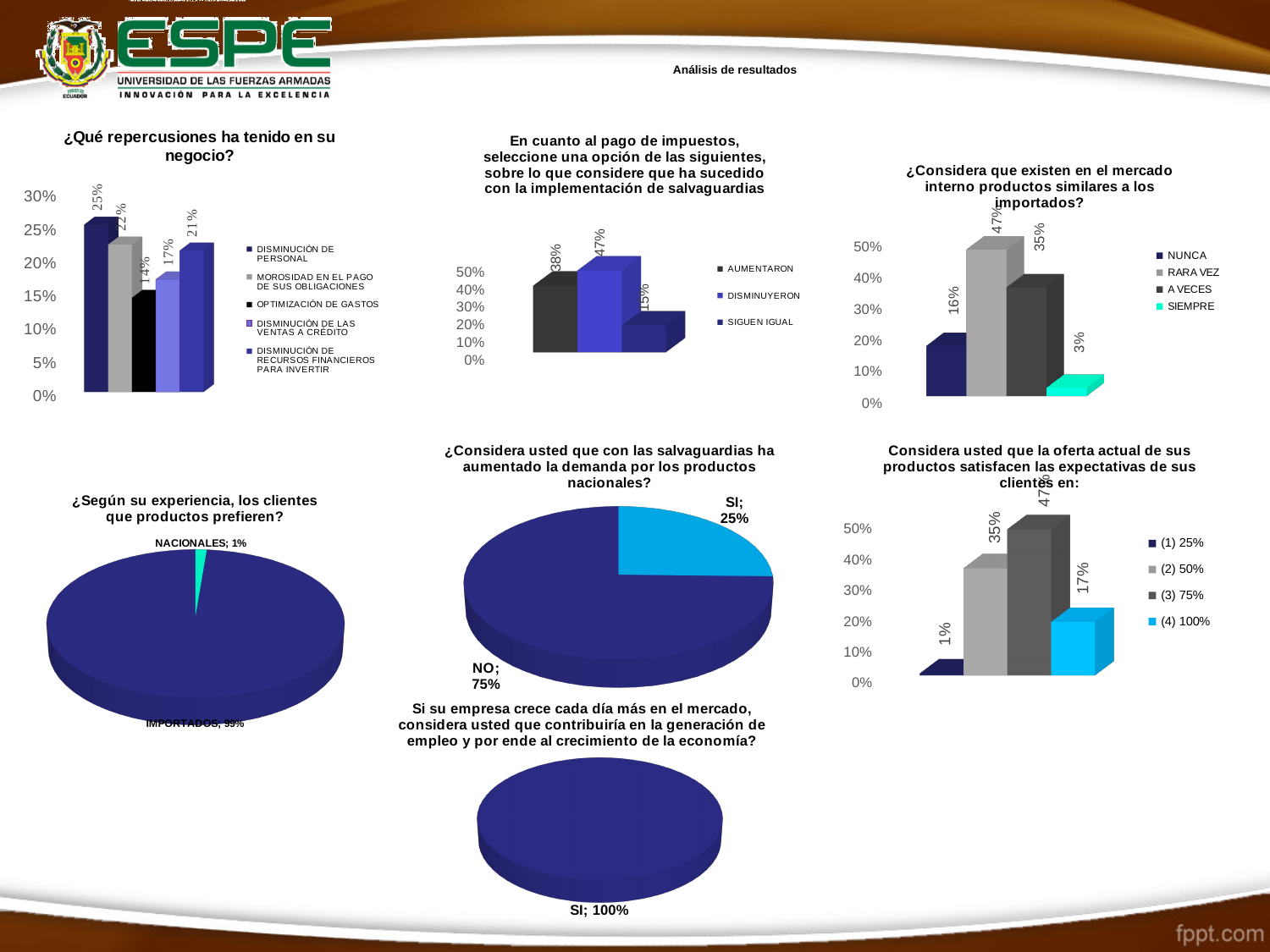
In the pie chart titled '¿Según su experiencia, los clientes que productos prefieren?', what share is IMPORTADOS? 99% In the pie chart titled '¿Considera usted que con las salvaguardias ha aumentado la demanda por los productos nacionales?', what share is NO? 75% What kind of chart is the one titled 'Si su empresa crece cada día más en el mercado, considera usted que contribuiría en la generación de empleo y por ende al crecimiento de la economía?'? Pie chart In the chart titled 'Considera usted que la oferta actual de sus productos satisfacen las expectativas de sus clientes en:', what is the value for (2) 50%? 35% In the chart titled '¿Qué repercusiones ha tenido en su negocio?', how many series does the legend list? 5 In the chart titled '¿Considera que existen en el mercado interno productos similares a los importados?', which is larger, NUNCA or A VECES? A VECES In the chart about 'En cuanto al pago de impuestos', what is the difference between AUMENTARON and SIGUEN IGUAL? 23% In the chart about 'En cuanto al pago de impuestos', what is the value for DISMINUYERON? 47% In the chart titled '¿Qué repercusiones ha tenido en su negocio?', what is the value for DISMINUCIÓN DE PERSONAL? 25% In the chart titled '¿Considera que existen en el mercado interno productos similares a los importados?', which category has the highest value? RARA VEZ In the chart titled '¿Qué repercusiones ha tenido en su negocio?', which category has the lowest value? OPTIMIZACIÓN DE GASTOS In the chart titled '¿Considera que existen en el mercado interno productos similares a los importados?', what is the value for SIEMPRE? 3%